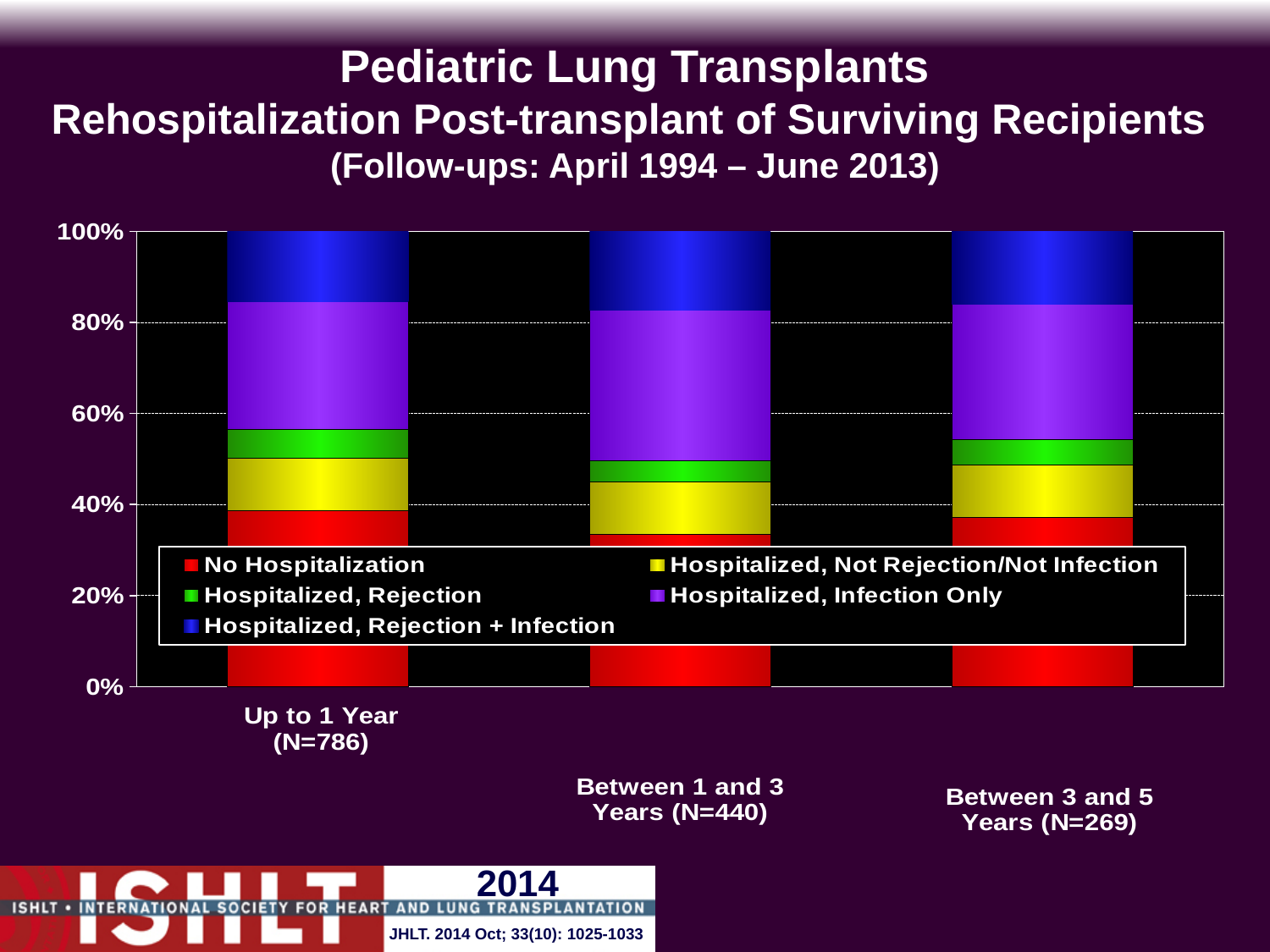
How many series does the legend list? 5 What is the total of each stacked bar? 100% What kind of chart is shown on the slide? Stacked bar chart Which colour represents Hospitalized, Rejection + Infection in the legend? Blue How many time-period categories are shown on the x axis? 3 Which time period has the smallest No Hospitalization segment? Between 1 and 3 Years (N=440) Is the No Hospitalization share for Up to 1 Year (N=786) greater or less than 40%? less Which has the larger No Hospitalization share: Up to 1 Year (N=786) or Between 1 and 3 Years (N=440)? Up to 1 Year (N=786) Is the No Hospitalization share for Between 3 and 5 Years (N=269) greater or less than 20%? greater Is the No Hospitalization share for Between 1 and 3 Years (N=440) greater or less than 40%? less Which time period has the largest Hospitalized, Infection Only segment? Between 1 and 3 Years (N=440) What is the sample size (N) for the Between 3 and 5 Years category? 269